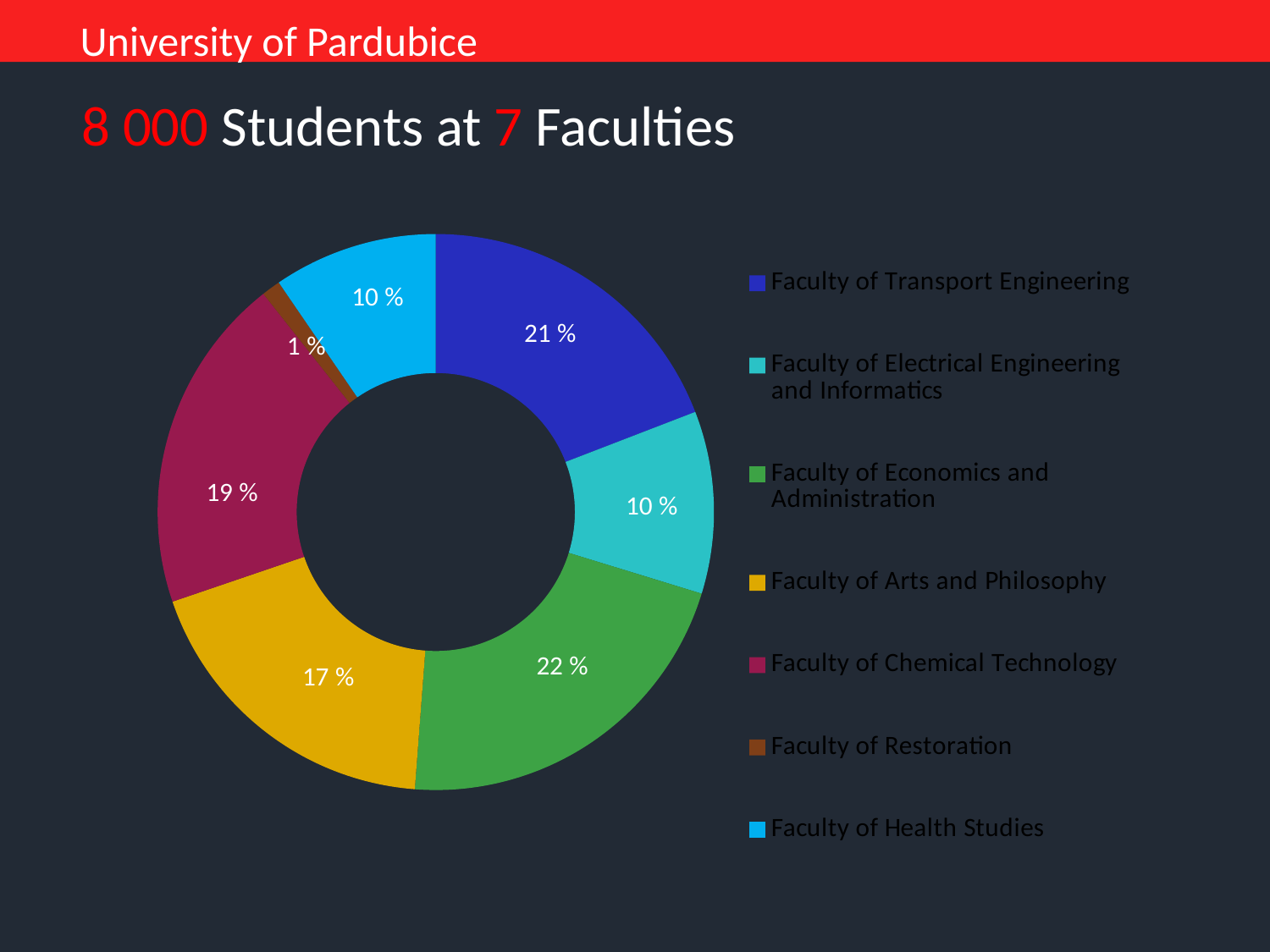
How many faculties are shown in the chart? 7 Which faculty has the smallest share of students? Faculty of Restoration What share of students is at the Faculty of Economics and Administration? 22 % What share of students is at the Faculty of Chemical Technology? 19 % What share of students is at the Faculty of Arts and Philosophy? 17 % What kind of chart is shown on the slide? Doughnut (pie) chart Which faculty has the largest share of students? Faculty of Economics and Administration What share of students is at the Faculty of Restoration? 1 % Which faculty is shown in yellow in the chart? Faculty of Arts and Philosophy What share of students is at the Faculty of Transport Engineering? 21 % What is the difference in percentage points between the Faculty of Chemical Technology and the Faculty of Arts and Philosophy? 2 Which has a larger share of students, the Faculty of Transport Engineering or the Faculty of Chemical Technology? Faculty of Transport Engineering